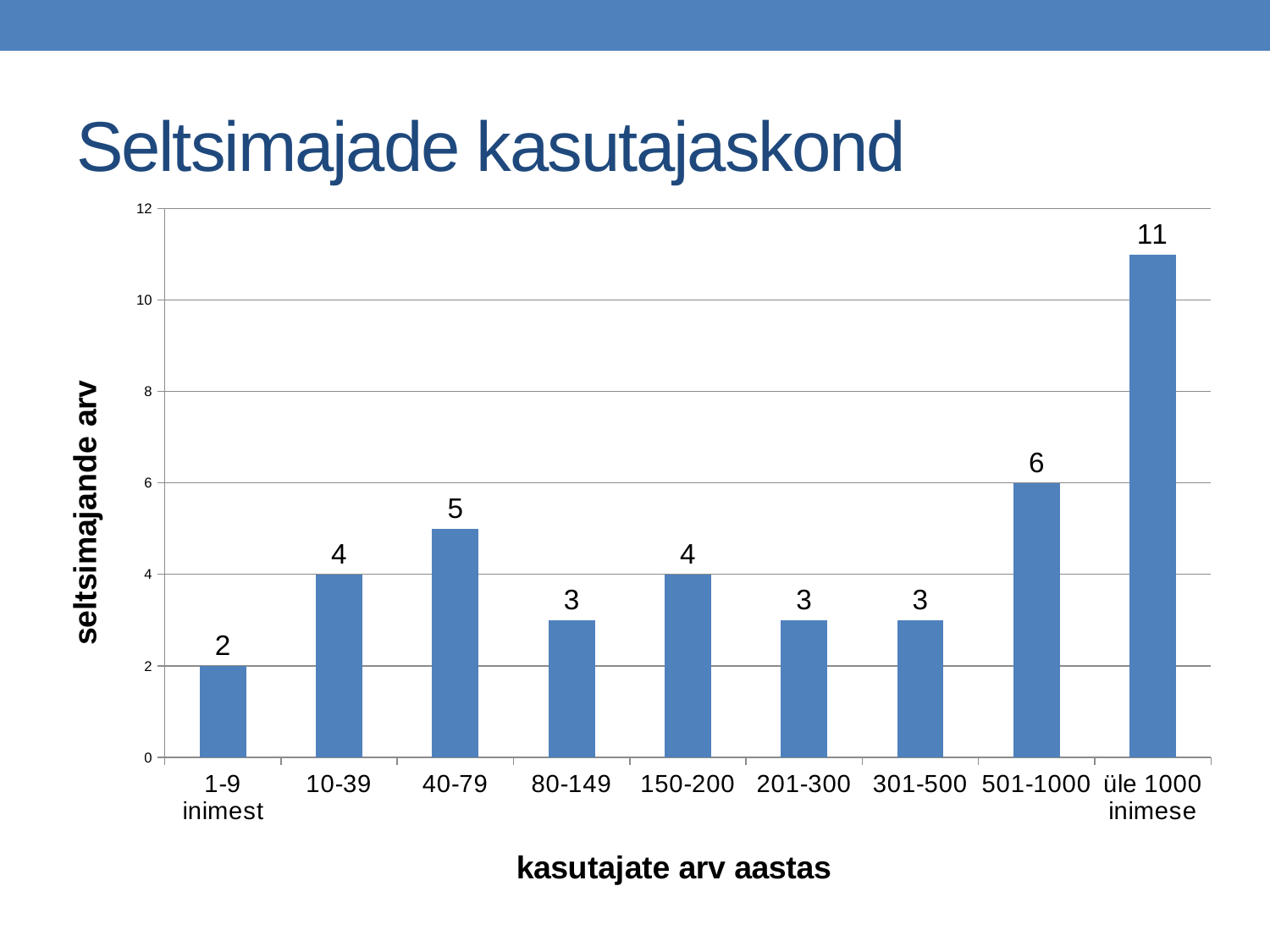
What kind of chart is shown on the slide? bar chart Which category has the lowest value? 1-9 inimest What is the value for the '40-79' category? 5 What is the value for the '1-9 inimest' category? 2 How many categories are shown on the x axis? 9 What is the title of the slide? Seltsimajade kasutajaskond What is the difference between the values for 'üle 1000 inimese' and '501-1000'? 5 Which category has the highest value? üle 1000 inimese Which is larger, the value for '10-39' or the value for '80-149'? 10-39 What is the label of the x axis? kasutajate arv aastas Is the value for 'üle 1000 inimese' greater or less than 10? greater What is the value for the '501-1000' category? 6